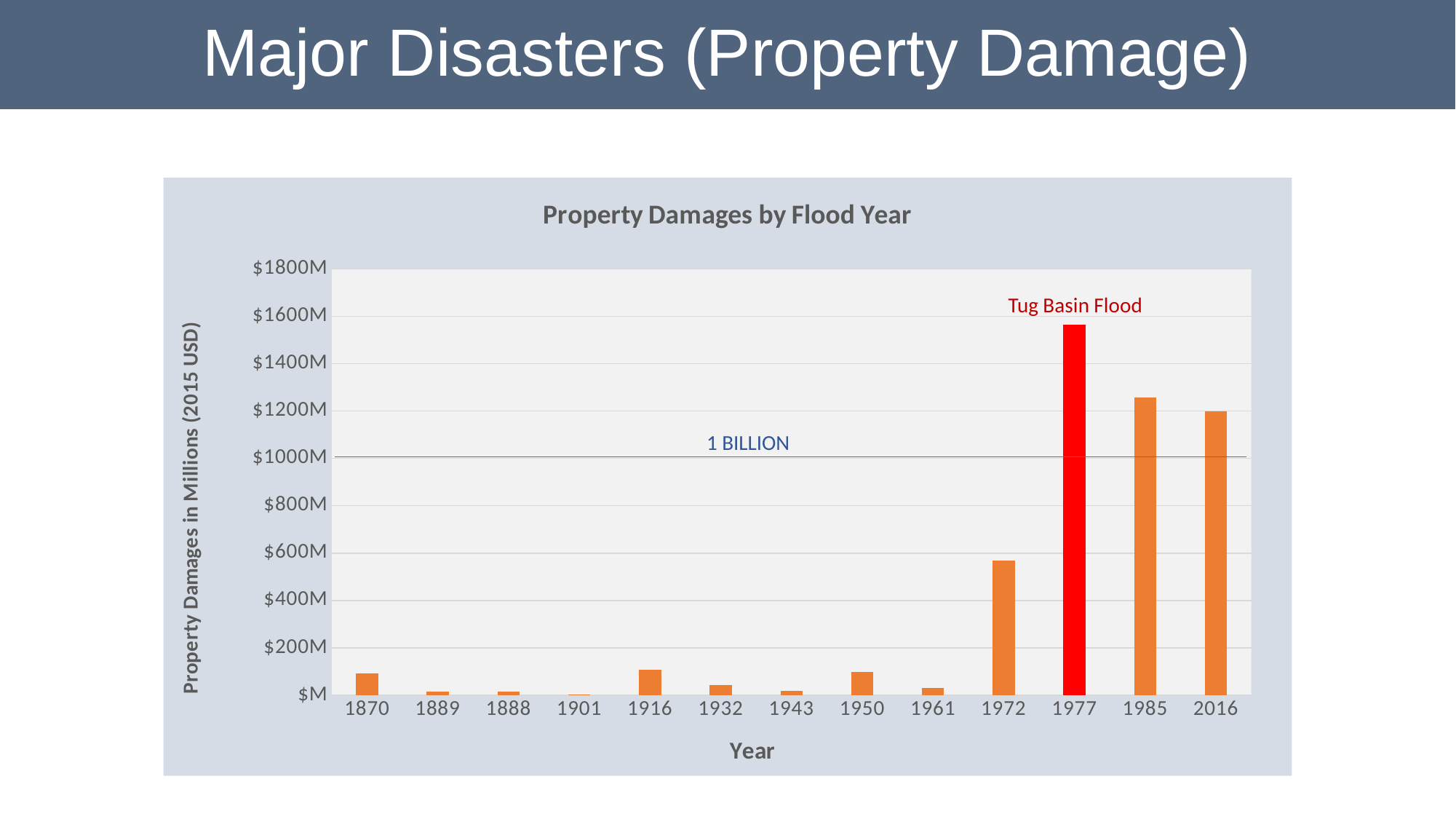
What is the title of the chart? Property Damages by Flood Year How many flood years are plotted on the x axis? 13 Which year has the highest property damages in the chart? 1977 Is the value for 1916 greater or less than $200M? less Is the value for 1972 greater or less than $800M? less Is the value for 2016 greater or less than $1000M? greater Which year has the lowest property damages in the chart? 1901 What label is attached to the red bar in the chart? Tug Basin Flood Which year has higher property damages, 1972 or 1961? 1972 What type of chart is shown on the slide? bar chart Which year has higher property damages, 1985 or 2016? 1985